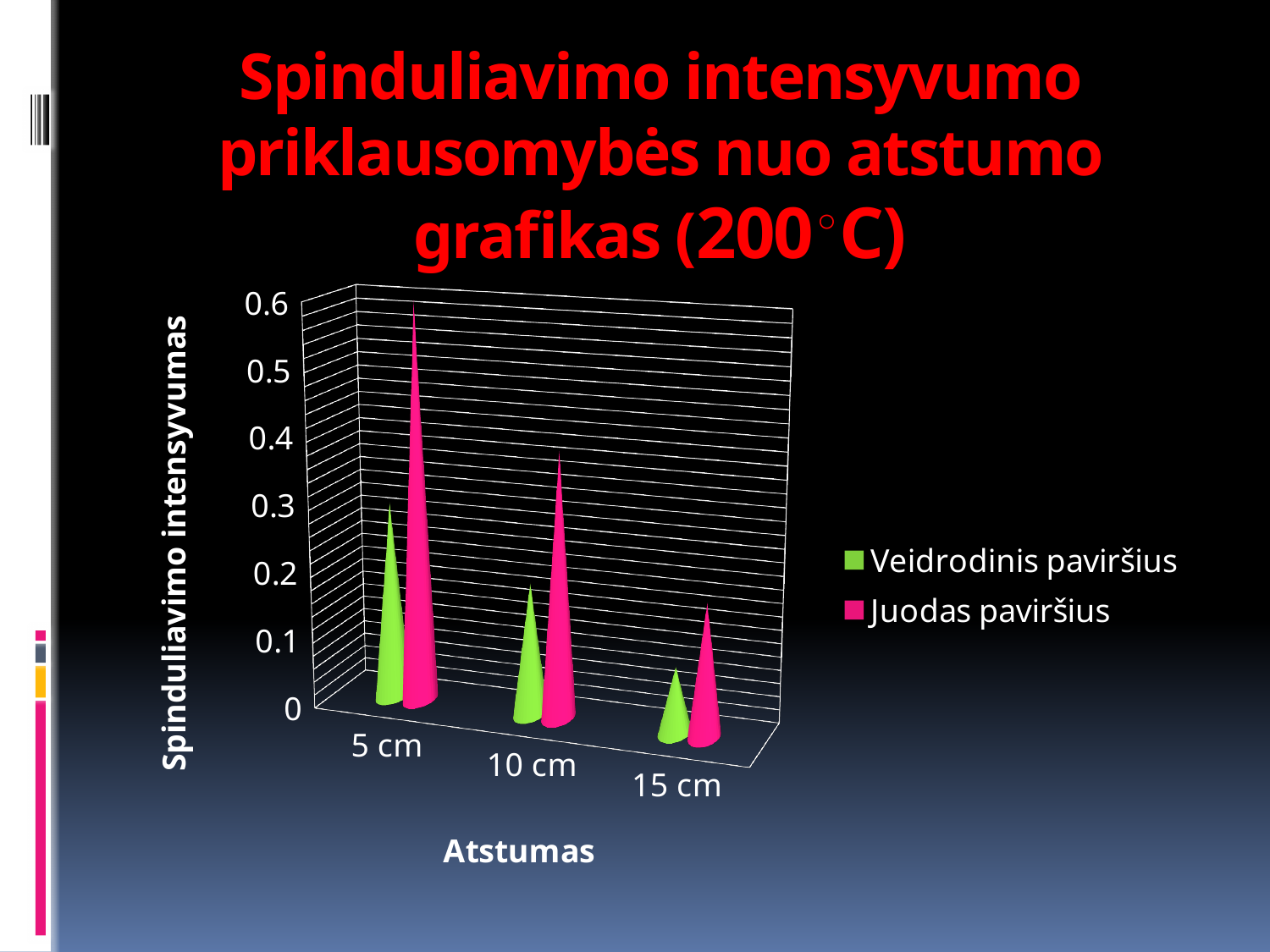
Is the value for Juodas paviršius at 15 cm greater or less than 0.3? less Is the value for Juodas paviršius at 5 cm greater or less than 0.4? greater What is the label of the y axis? Spinduliavimo intensyvumas Is the value for Veidrodinis paviršius at 5 cm greater or less than 0.4? less How many distance categories are shown on the x axis? 3 At 5 cm, which series has the larger value, Veidrodinis paviršius or Juodas paviršius? Juodas paviršius How many series does the legend list? 2 Do the values for Juodas paviršius rise or fall as the distance increases from 5 cm to 15 cm? fall Which series is shown in pink? Juodas paviršius At which distance is the value for Veidrodinis paviršius lowest? 15 cm What kind of chart is shown on the slide? bar chart At which distance is the value for Juodas paviršius highest? 5 cm